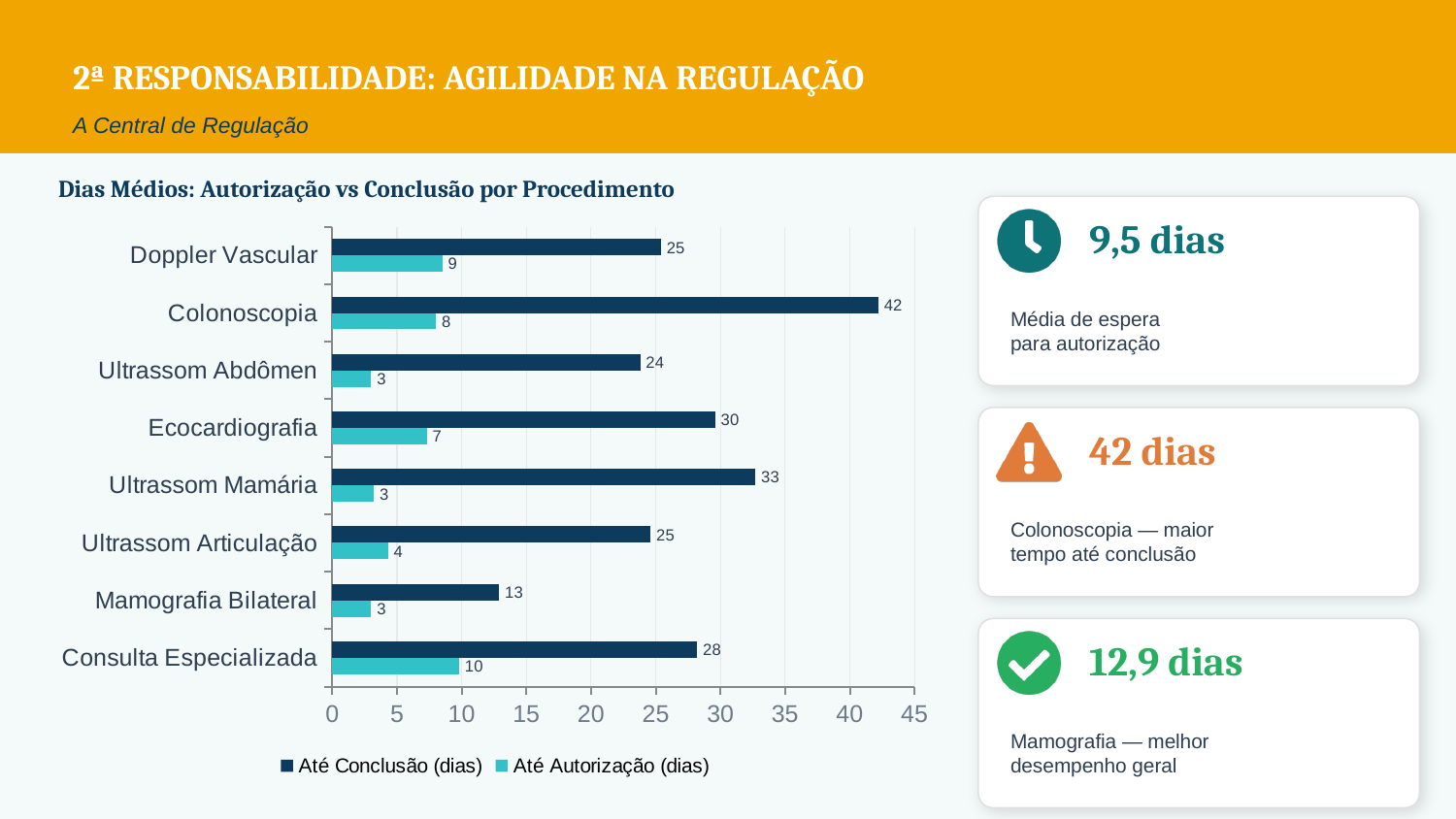
How many series does the legend list? 2 What is the 'Até Conclusão (dias)' value for Colonoscopia? 42 What is the title of the chart? Dias Médios: Autorização vs Conclusão por Procedimento What kind of chart is shown on the slide? Bar chart Which procedure has the highest 'Até Conclusão (dias)' value? Colonoscopia How many procedures are shown in the chart? 8 What is the 'Até Autorização (dias)' value for Consulta Especializada? 10 What is the 'Até Conclusão (dias)' value for Ultrassom Mamária? 33 Which is larger: the 'Até Conclusão (dias)' value for Ecocardiografia or for Ultrassom Abdômen? Ecocardiografia Which procedure has the highest 'Até Autorização (dias)' value? Consulta Especializada What is the difference between the 'Até Conclusão' and 'Até Autorização' values for Colonoscopia? 34 Which procedure has the lowest 'Até Conclusão (dias)' value? Mamografia Bilateral